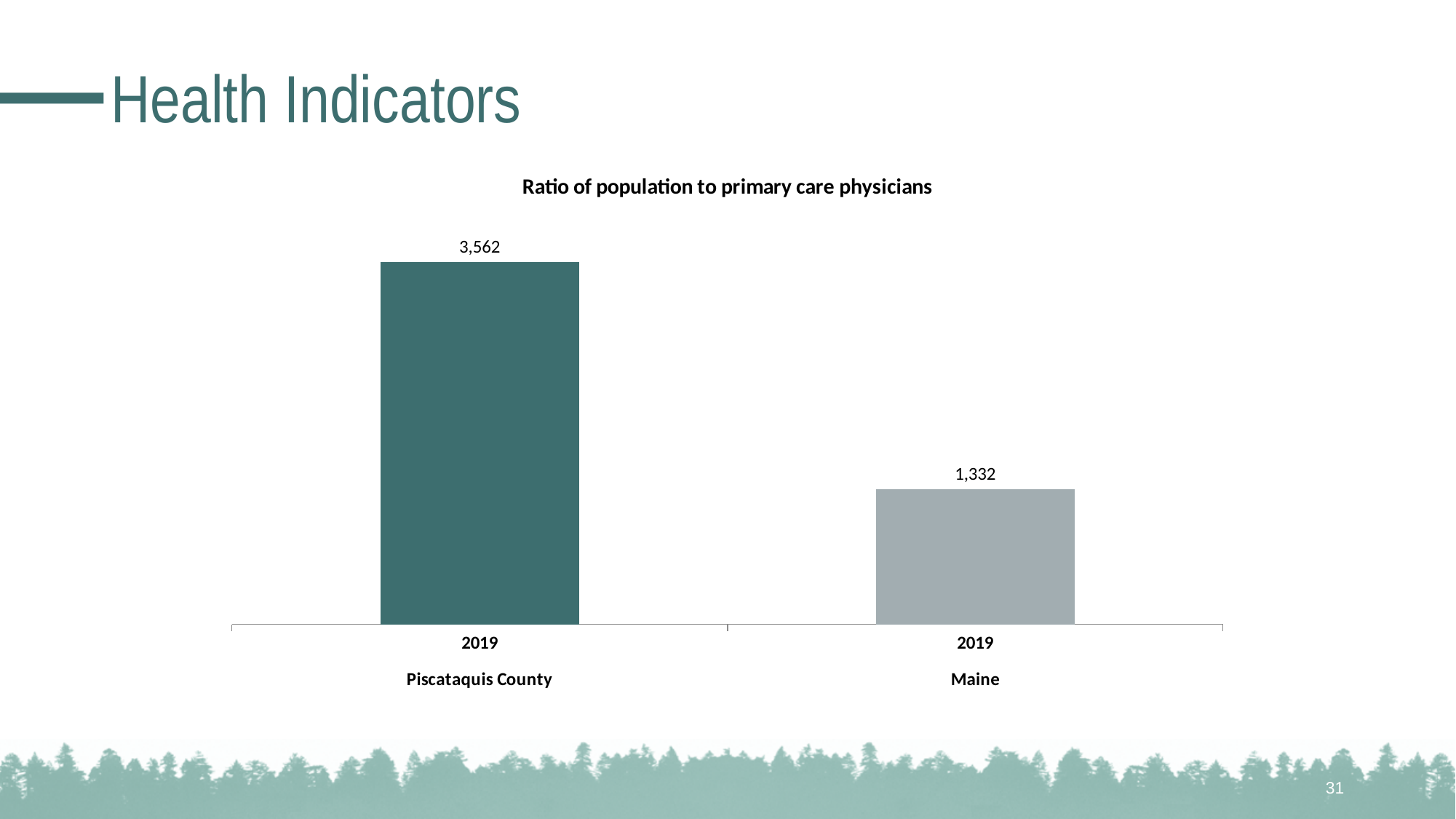
What kind of chart is shown on the slide? bar chart Which category has the lower ratio of population to primary care physicians? Maine What year is shown beneath both bars in the chart? 2019 Is the value for Piscataquis County larger or smaller than the value for Maine? larger What is the difference between the Piscataquis County value and the Maine value? 2,230 How many bars are plotted in the chart? 2 Which category has the higher ratio of population to primary care physicians? Piscataquis County What is the ratio of population to primary care physicians for Piscataquis County? 3,562 What is the title of the chart? Ratio of population to primary care physicians What is the ratio of population to primary care physicians for Maine? 1,332